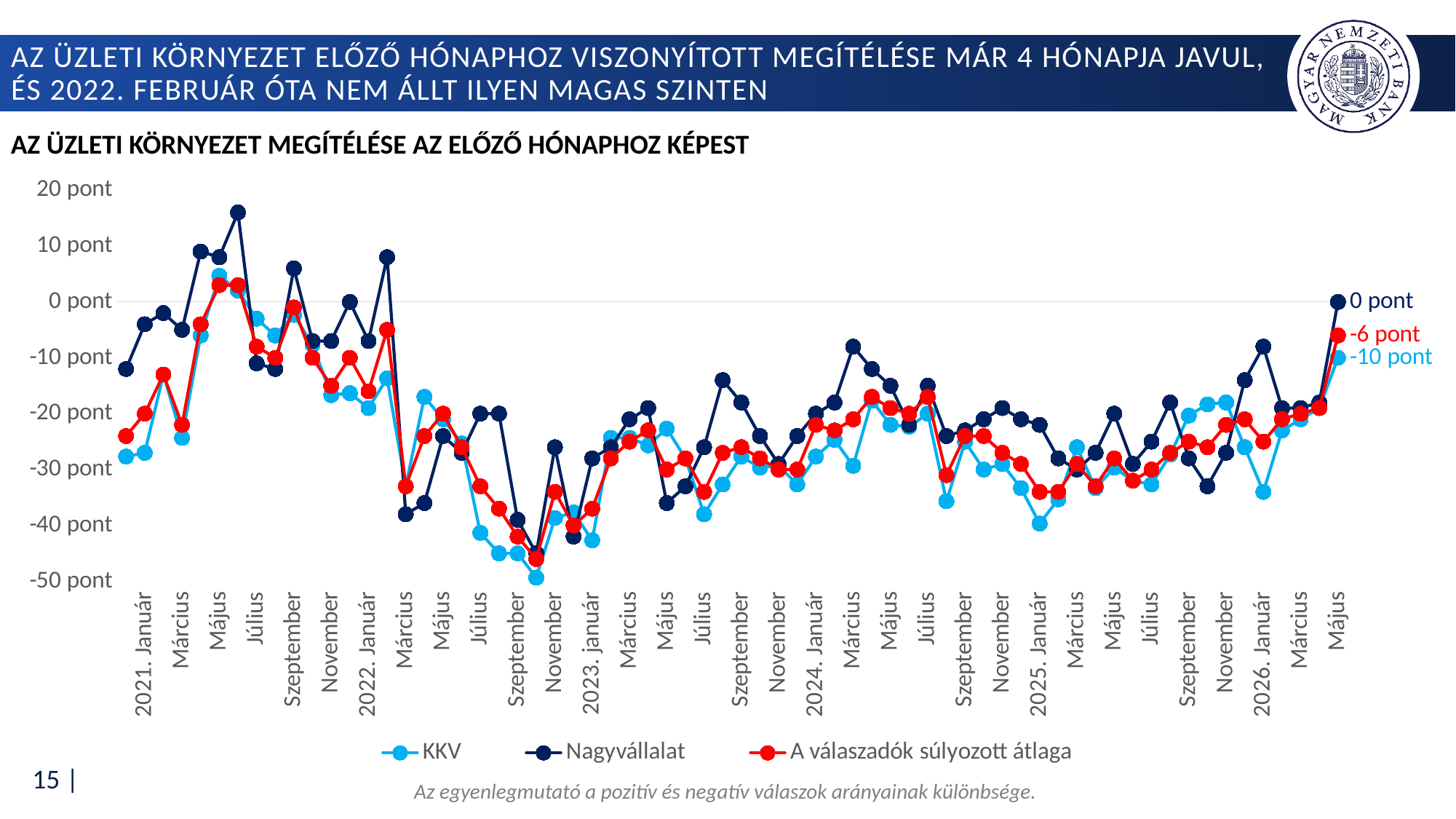
What kind of chart is shown on the slide? line chart What is the title of the chart? AZ ÜZLETI KÖRNYEZET MEGÍTÉLÉSE AZ ELŐZŐ HÓNAPHOZ KÉPEST What is the value for Nagyvállalat at the last point (2026 Május)? 0 pont What is the value for A válaszadók súlyozott átlaga at the last point (2026 Május)? -6 pont Is the lowest value reached by the KKV series greater or less than -40 pont? less At 2026 Május, what is the difference between A válaszadók súlyozott átlaga and KKV? 4 pont What is the value for KKV at the last point (2026 Május)? -10 pont At 2026 Május, what is the difference between the Nagyvállalat value and the KKV value? 10 pont Which series has the lowest value at 2026 Május? KKV Is the highest value reached by the Nagyvállalat series greater or less than 10 pont? greater At 2026 Május, which series has the higher value, KKV or Nagyvállalat? Nagyvállalat How many series does the legend list? 3